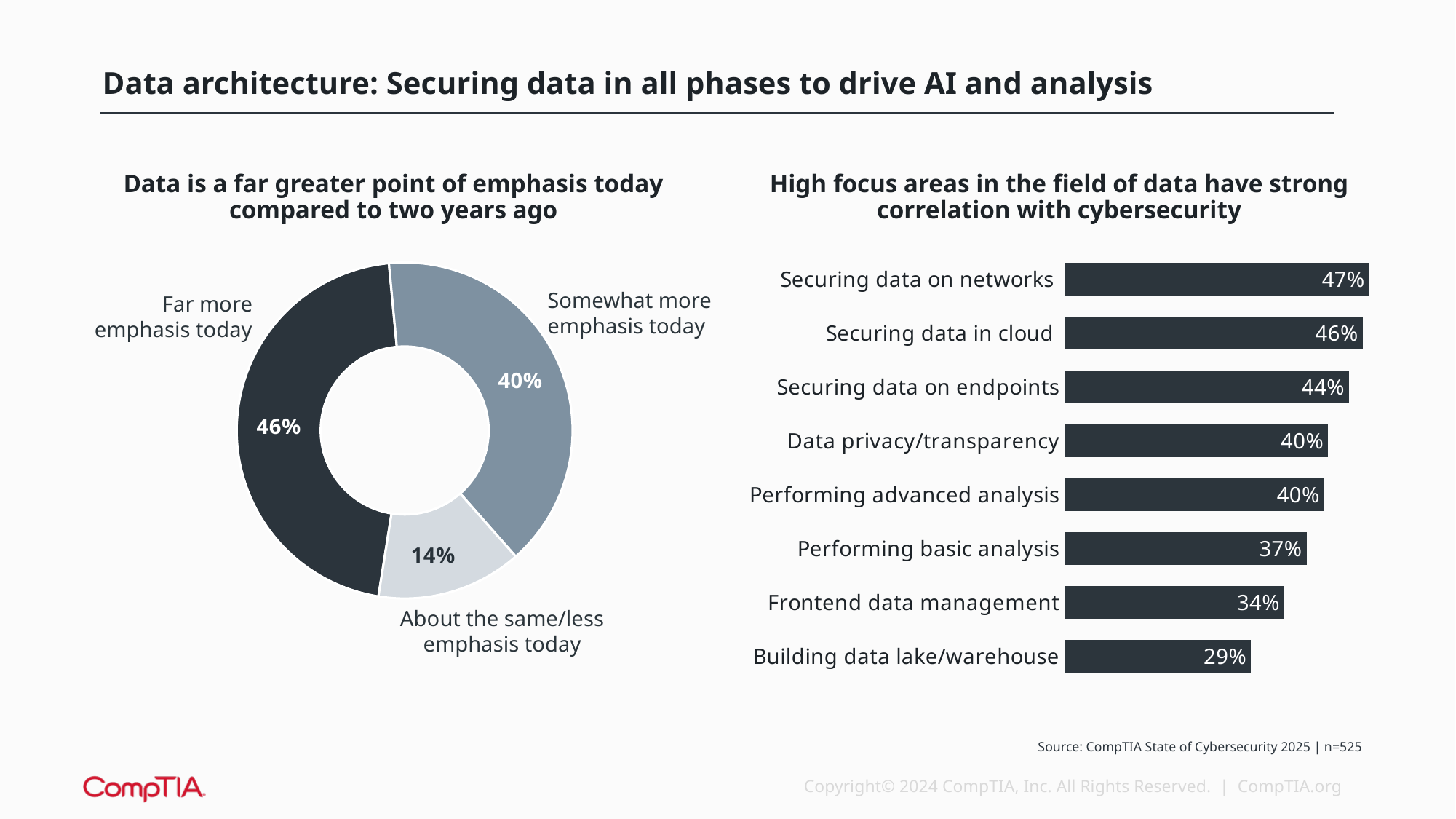
In the left chart (Data is a far greater point of emphasis today compared to two years ago), what share of respondents say there is far more emphasis today? 46% In the right chart (High focus areas in the field of data have strong correlation with cybersecurity), which is larger: Performing basic analysis or Frontend data management? Performing basic analysis In the right chart (High focus areas in the field of data have strong correlation with cybersecurity), what is the difference between Securing data on networks and Building data lake/warehouse? 18 percentage points In the right chart (High focus areas in the field of data have strong correlation with cybersecurity), which category has the lowest value? Building data lake/warehouse In the left chart (Data is a far greater point of emphasis today compared to two years ago), what share say there is about the same/less emphasis today? 14% In the left chart (Data is a far greater point of emphasis today compared to two years ago), how many slices does the donut have? 3 In the right chart (High focus areas in the field of data have strong correlation with cybersecurity), what is the value for Securing data in cloud? 46% In the right chart (High focus areas in the field of data have strong correlation with cybersecurity), which category has the highest value? Securing data on networks In the right chart (High focus areas in the field of data have strong correlation with cybersecurity), how many categories are shown? 8 What kind of chart is the right chart (High focus areas in the field of data have strong correlation with cybersecurity)? Bar chart In the left chart (Data is a far greater point of emphasis today compared to two years ago), which category has the largest slice? Far more emphasis today What kind of chart is the left chart (Data is a far greater point of emphasis today compared to two years ago)? Donut (pie) chart